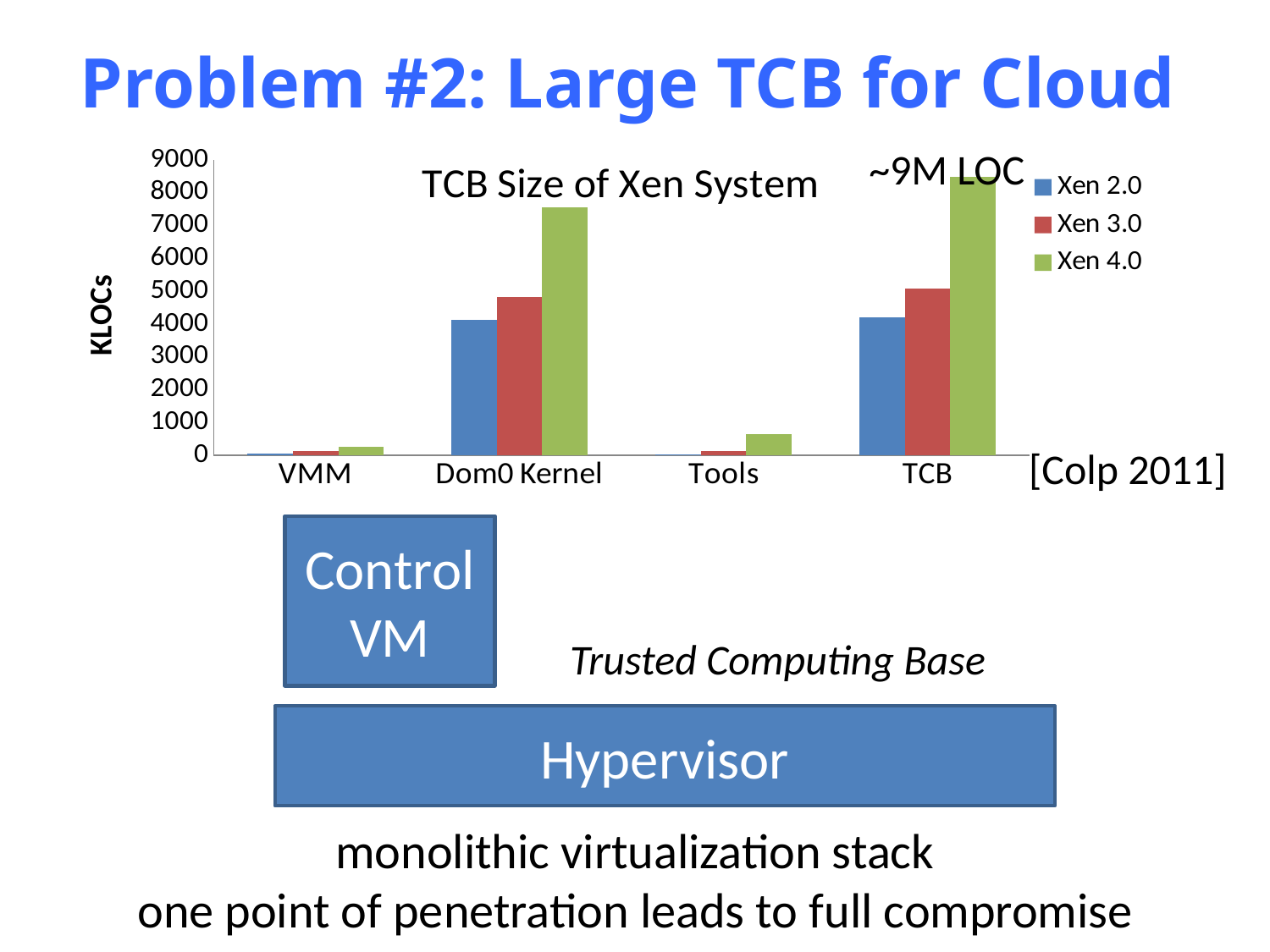
How many categories are shown on the x axis of the chart? 4 Is the Xen 2.0 value for Dom0 Kernel greater or less than 5000? less Is the Xen 4.0 value for TCB greater or less than 8000? greater What is the label on the y axis of the chart? KLOCs Is the Xen 4.0 value for Dom0 Kernel greater or less than 7000? greater How many series does the legend of the chart list? 3 What kind of chart is shown on the slide? bar chart For the TCB category, which series has the larger value, Xen 2.0 or Xen 4.0? Xen 4.0 Which category has the lowest Xen 4.0 value? VMM What is the title of the chart? TCB Size of Xen System Which category has the highest Xen 4.0 value? TCB